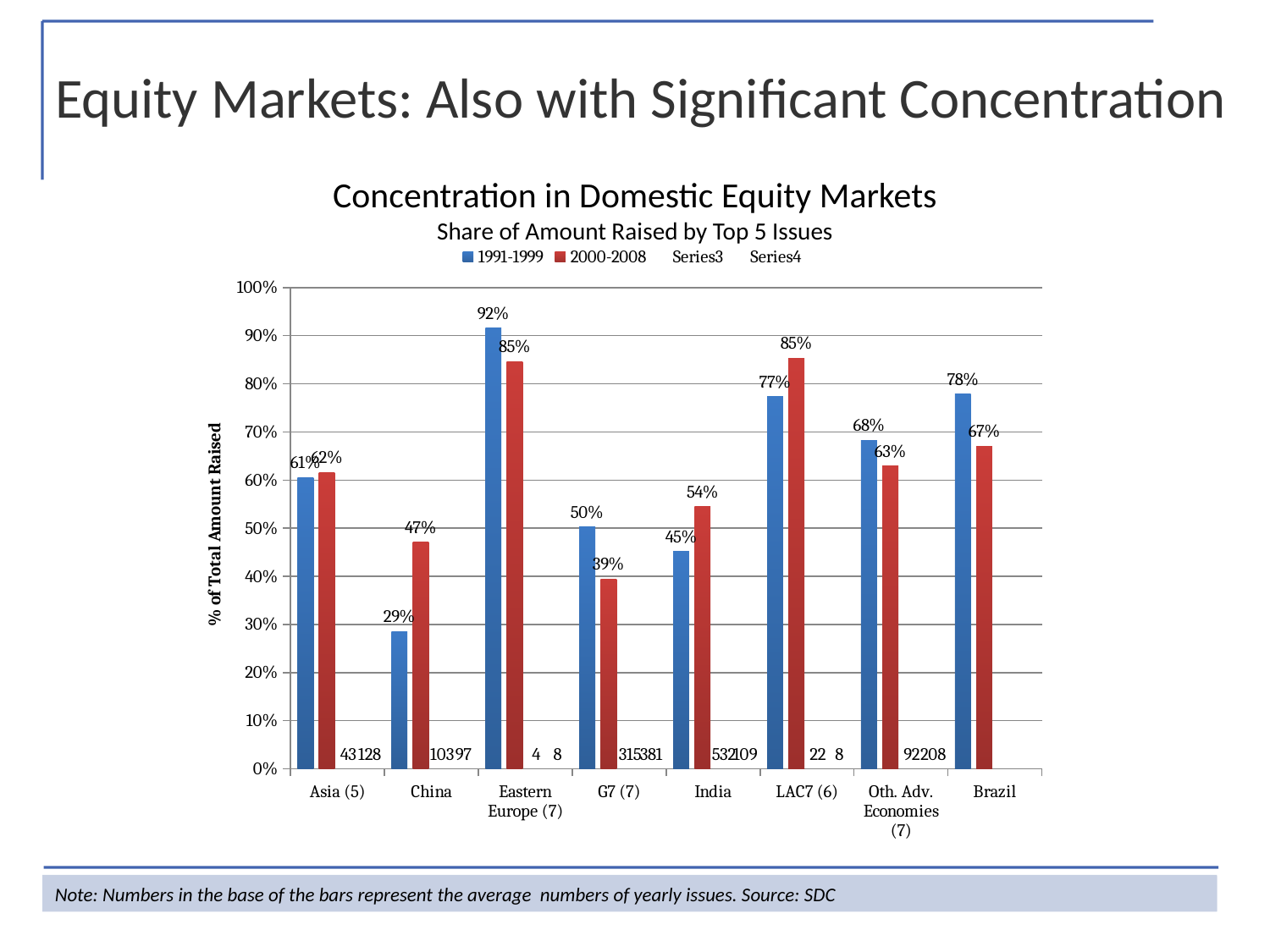
What is the 2000-2008 value for Brazil? 67% Which category has the lowest 2000-2008 value? G7 (7) What is the difference between the 2000-2008 and 1991-1999 values for China? 18 percentage points What is the label of the y axis? % of Total Amount Raised Is the 1991-1999 value for LAC7 (6) greater or less than 70%? greater For India, which period has the larger value, 1991-1999 or 2000-2008? 2000-2008 What type of chart is shown? Bar chart Which category has the highest 1991-1999 value? Eastern Europe (7) What is the 1991-1999 value for China? 29% What is the 2000-2008 value for India? 54% What is the 1991-1999 value for Eastern Europe (7)? 92% How many categories are shown on the x axis? 8